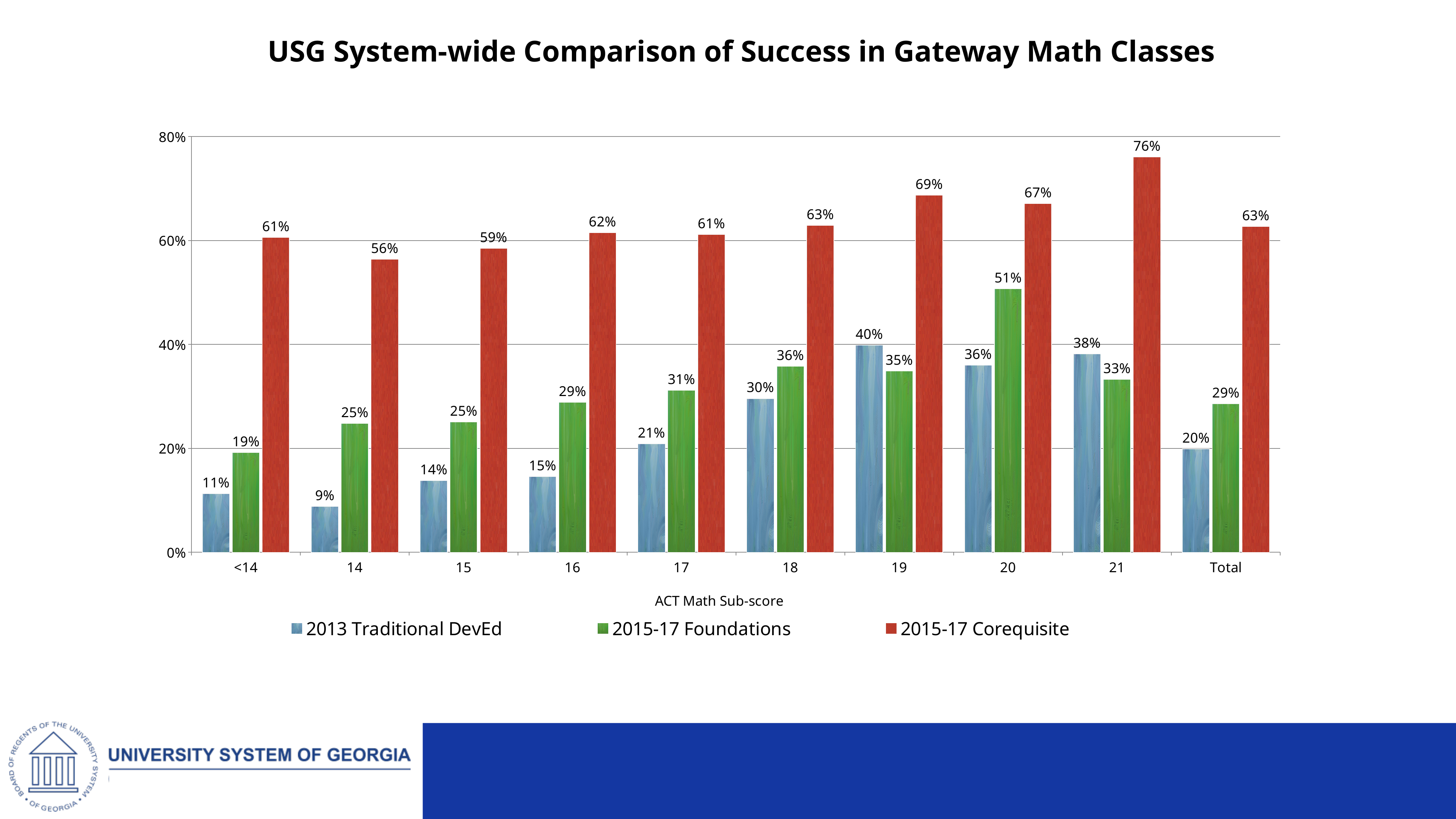
What is the 2013 Traditional DevEd success rate for an ACT Math Sub-score of 14? 9% How many series does the legend list? 3 Is the 2015-17 Corequisite value for an ACT Math Sub-score of 19 greater or less than 60%? greater For an ACT Math Sub-score of 20, which is larger: the 2015-17 Foundations rate or the 2013 Traditional DevEd rate? 2015-17 Foundations What kind of chart is shown on the slide? bar chart Which ACT Math Sub-score category has the highest 2015-17 Corequisite success rate? 21 Which ACT Math Sub-score category has the lowest 2013 Traditional DevEd success rate? 14 What is the 2015-17 Foundations success rate for the Total category? 29% What is the 2015-17 Corequisite success rate for an ACT Math Sub-score of 21? 76% What is the difference between the 2015-17 Corequisite and 2013 Traditional DevEd success rates for the Total category? 43% How many categories are shown on the x axis? 10 What is the x-axis title of the chart? ACT Math Sub-score